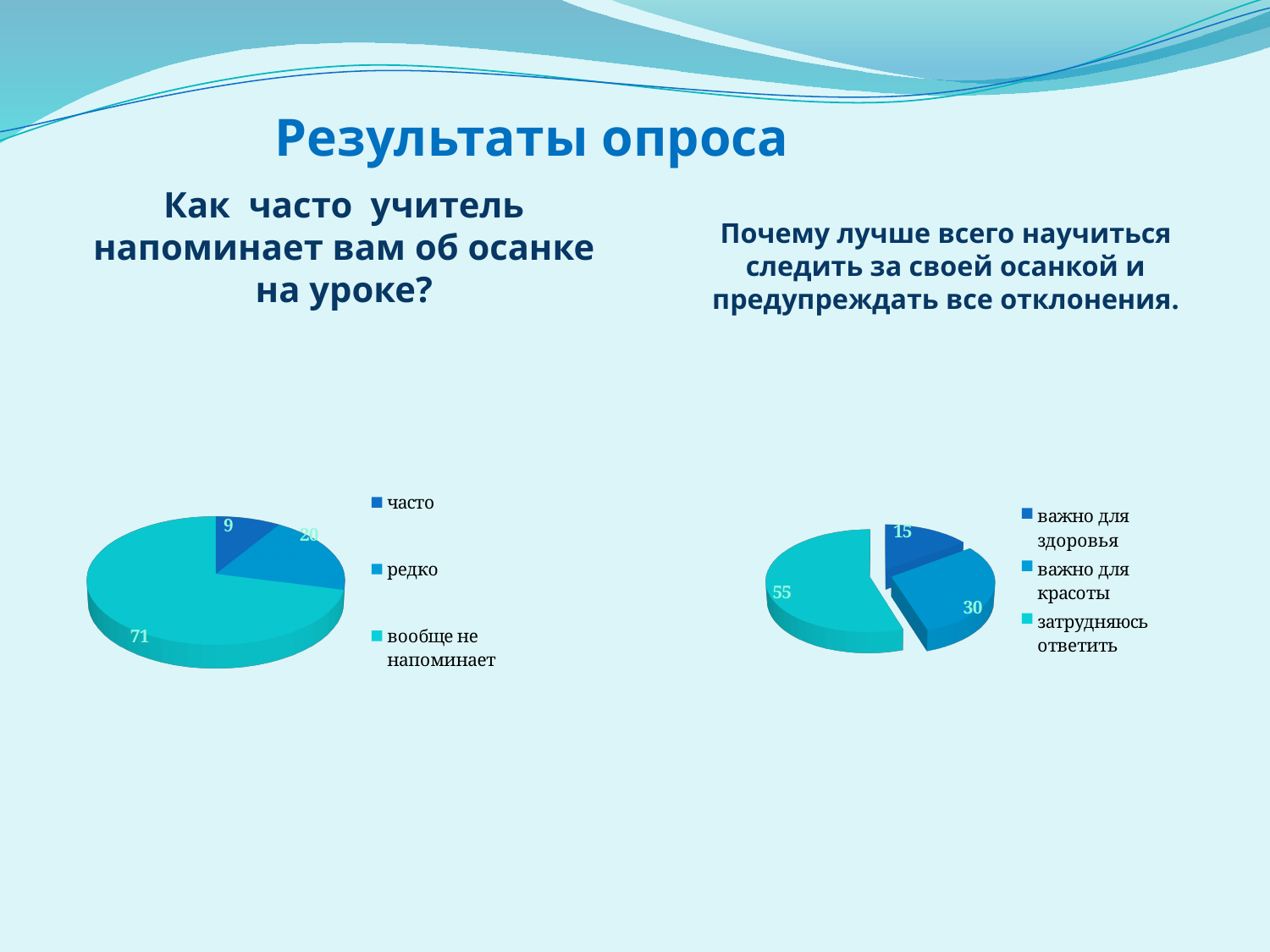
In the left pie chart ("Как часто учитель напоминает вам об осанке на уроке?"), what is the value for "редко"? 20 What type of chart is used on the right side of the slide? pie chart What is the main title of the slide? Результаты опроса In the right pie chart, which is larger: "важно для красоты" or "важно для здоровья"? важно для красоты In the left pie chart, what is the difference between the values for "вообще не напоминает" and "редко"? 51 In the left pie chart, what is the value for "вообще не напоминает"? 71 In the left pie chart, how many categories are shown? 3 In the right pie chart ("Почему лучше всего научиться следить за своей осанкой..."), what is the value for "важно для здоровья"? 15 In the left pie chart, which category has the smallest value? часто In the left pie chart, which category has the largest value? вообще не напоминает In the right pie chart, what is the value for "затрудняюсь ответить"? 55 In the right pie chart, what is the difference between the values for "затрудняюсь ответить" and "важно для красоты"? 25